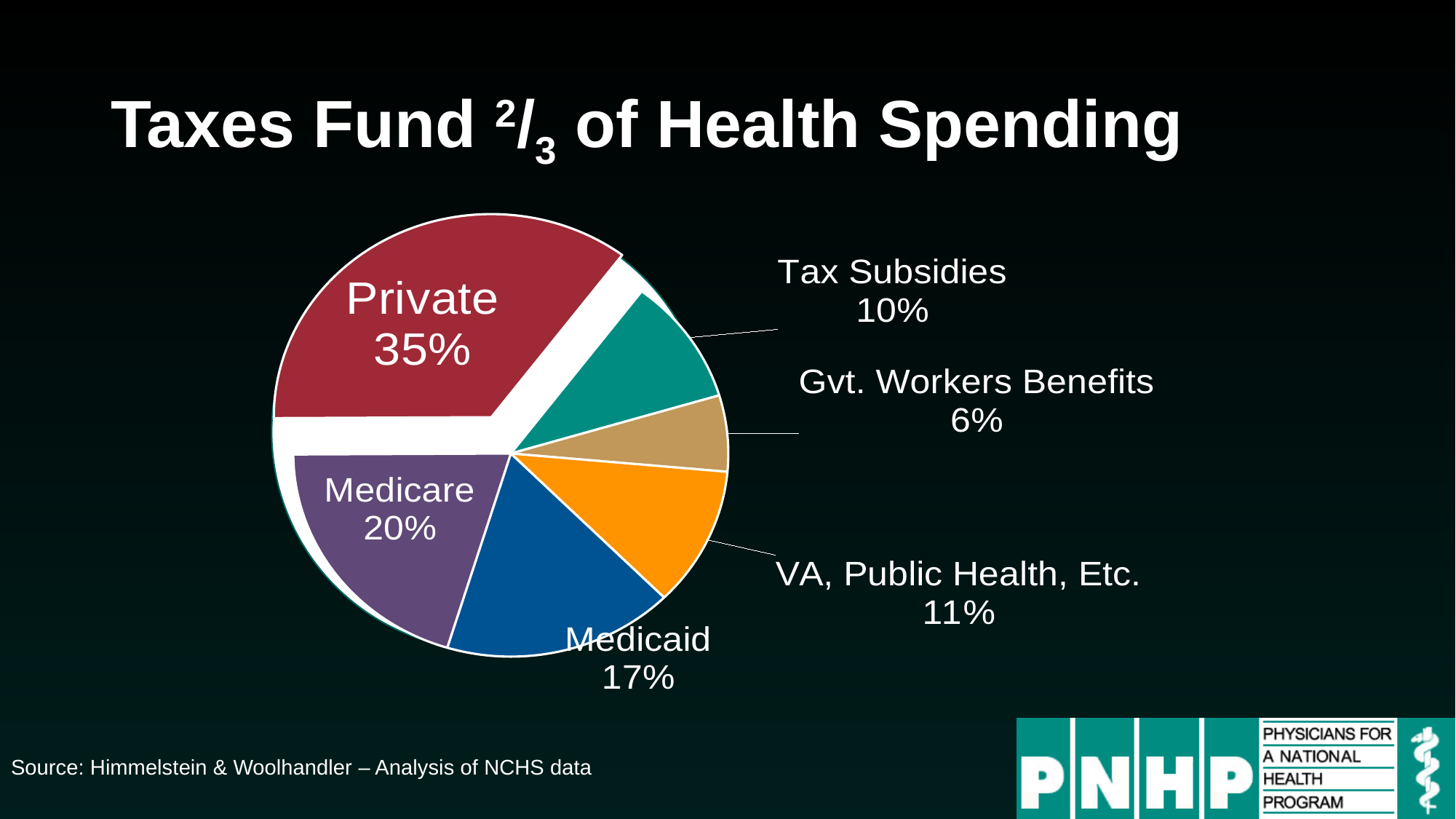
What is the value shown for Medicare? 20% What kind of chart is shown on the slide? pie chart What is the value shown for Tax Subsidies? 10% What is the value shown for Gvt. Workers Benefits? 6% What is the value shown for Medicaid? 17% What share of health spending does the Private slice represent? 35% What is the value shown for VA, Public Health, Etc.? 11% Which slice of the pie is the largest? Private Which slice of the pie is the smallest? Gvt. Workers Benefits Which is larger, the Medicaid share or the VA, Public Health, Etc. share? Medicaid How many slices does the pie chart have? 6 What is the difference between the Private share and the Medicare share? 15%